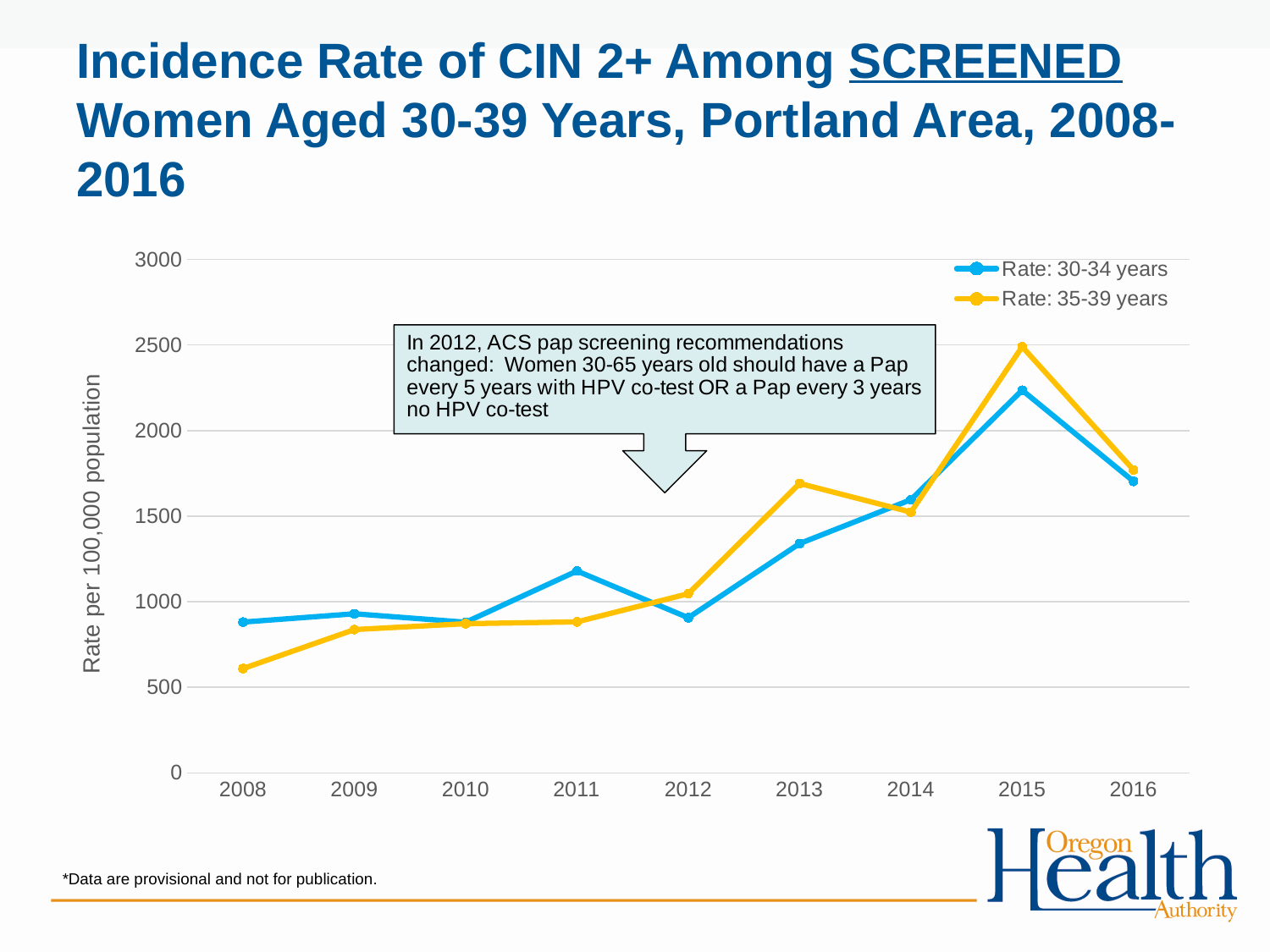
In which year is the rate for 35-39 years lowest? 2008 What kind of chart is shown on the slide? line chart Is the rate for 35-39 years in 2013 greater or less than 1500? greater How many years are plotted along the x axis? 9 In which year is the rate for 35-39 years highest? 2015 Is the rate for 30-34 years in 2012 greater or less than 1000? less Is the rate for 30-34 years in 2015 greater or less than 2000? greater What is the label on the y axis? Rate per 100,000 population In 2011, which series has the higher rate, 30-34 years or 35-39 years? 30-34 years How many series does the legend list? 2 In 2015, which series has the higher rate, 30-34 years or 35-39 years? 35-39 years In which year is the rate for 30-34 years highest? 2015